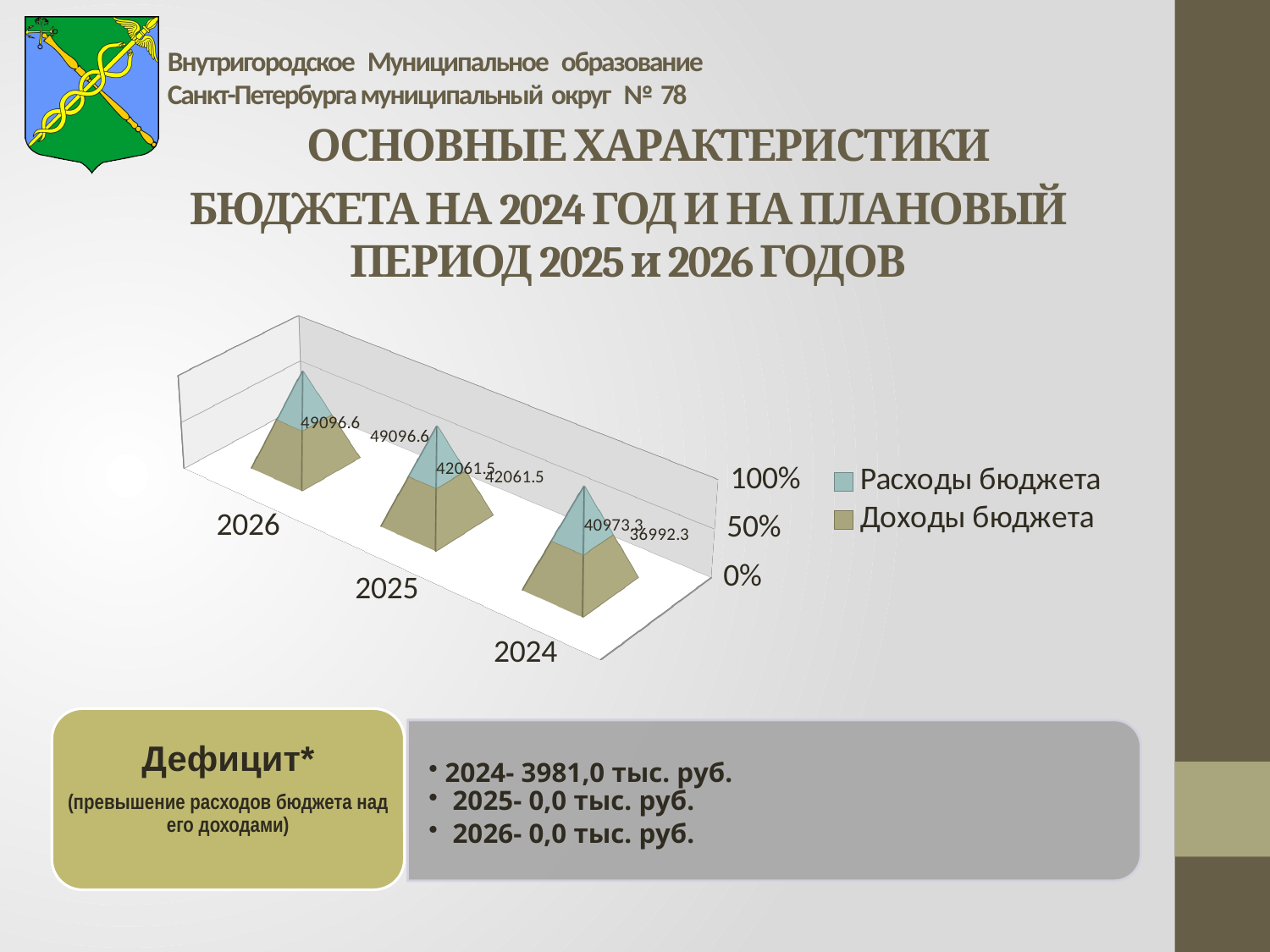
How many years are shown on the chart? 3 Which year has the highest value of Доходы бюджета? 2026 What is the value of Доходы бюджета for 2024? 36992.3 Do the values of Расходы бюджета rise or fall from 2024 to 2026? rise In 2024, which is larger: Расходы бюджета or Доходы бюджета? Расходы бюджета What is the value of Расходы бюджета for 2024? 40973.3 What is the value of Расходы бюджета for 2026? 49096.6 Which year has the lowest value of Расходы бюджета? 2024 What is the difference between Расходы бюджета and Доходы бюджета in 2024? 3981.0 How many series does the legend list? 2 Which series is shown in the teal (light blue) colour in the legend? Расходы бюджета What is the value of Доходы бюджета for 2025? 42061.5